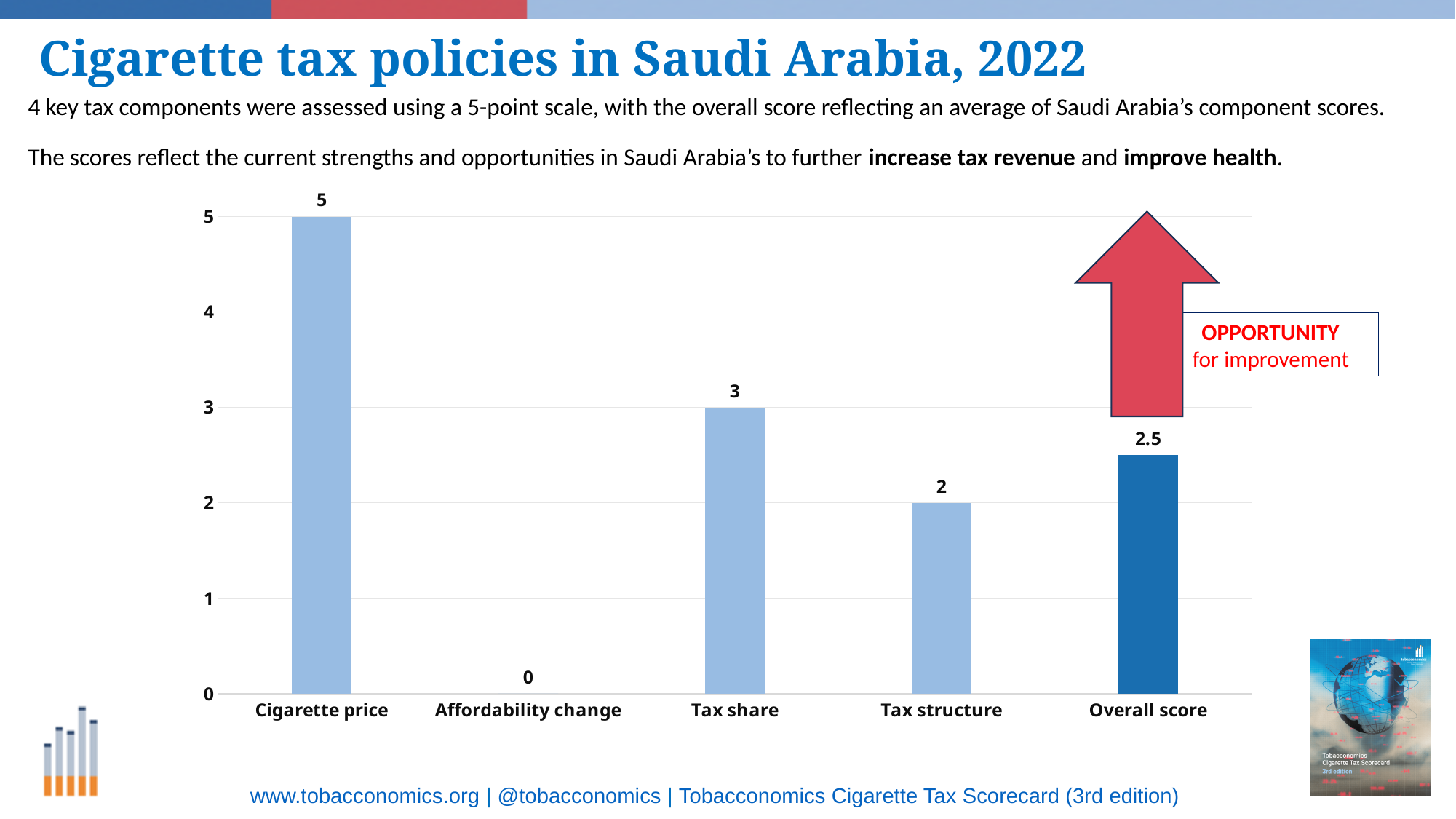
What is the score for Tax share? 3 How many categories are shown on the x axis? 5 What text appears in the box next to the red arrow? OPPORTUNITY for improvement Which category has the highest score? Cigarette price What is the score for Cigarette price? 5 Which category has the lowest score? Affordability change What is the score for Affordability change? 0 What is the score for Tax structure? 2 Which is larger, the Tax share score or the Tax structure score? Tax share What kind of chart is shown on the slide? Bar chart What is the difference between the Cigarette price score and the Tax share score? 2 What is the Overall score? 2.5